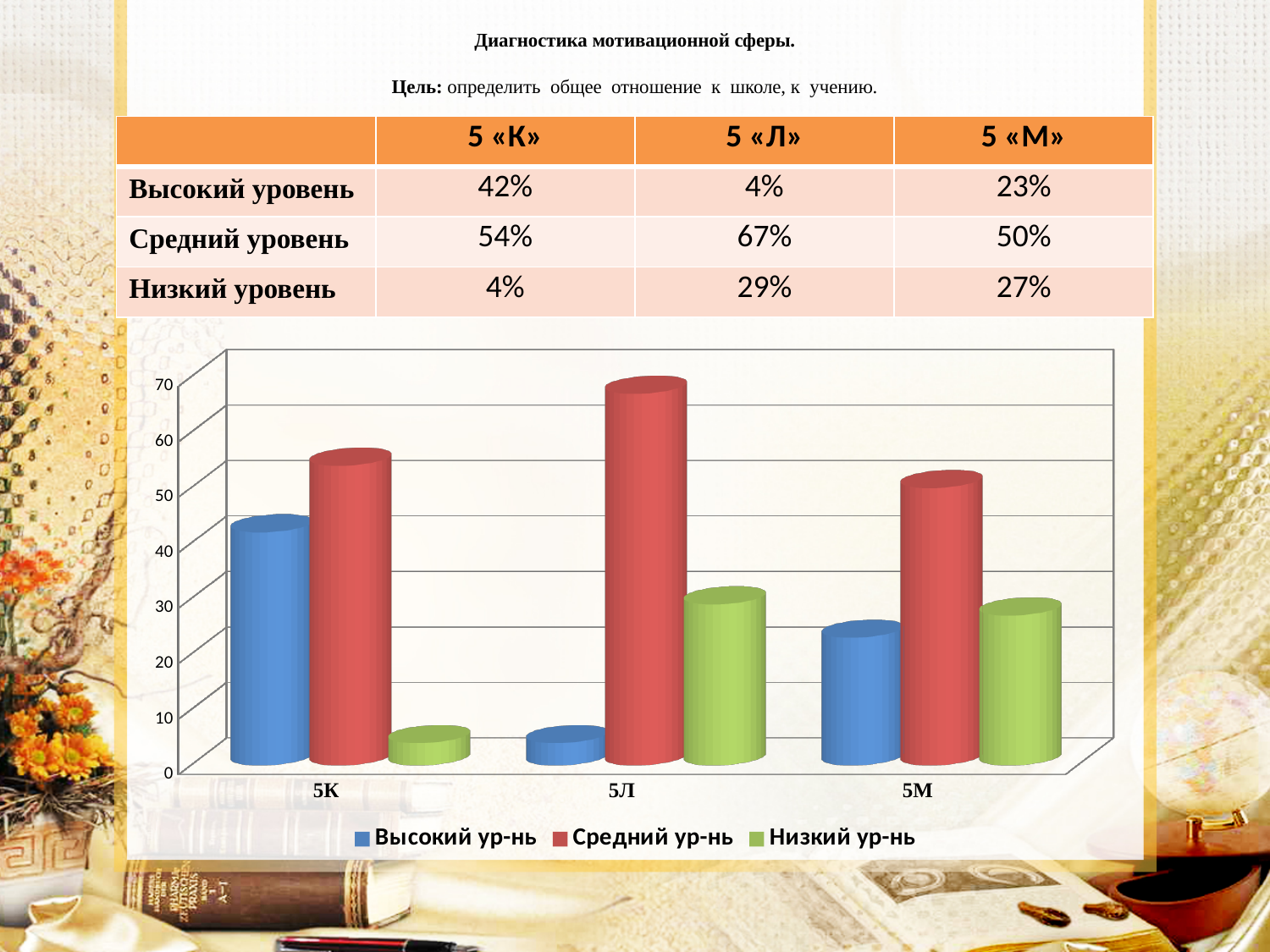
Is the value for Высокий ур-нь in 5М greater or less than 30? less Which is larger in 5К: Высокий ур-нь or Средний ур-нь? Средний ур-нь Is the value for Средний ур-нь in 5Л greater or less than 60? greater What kind of chart is shown on the slide? bar chart Which is larger in 5М: Высокий ур-нь or Низкий ур-нь? Низкий ур-нь Which class has the lowest value for Высокий ур-нь? 5Л How many class categories are shown on the x axis of the chart? 3 Which class has the highest value for Средний ур-нь? 5Л What colour represents Средний ур-нь in the chart? red Which class has the lowest value for Низкий ур-нь? 5К Is the value for Низкий ур-нь in 5К greater or less than 10? less How many series does the chart legend list? 3